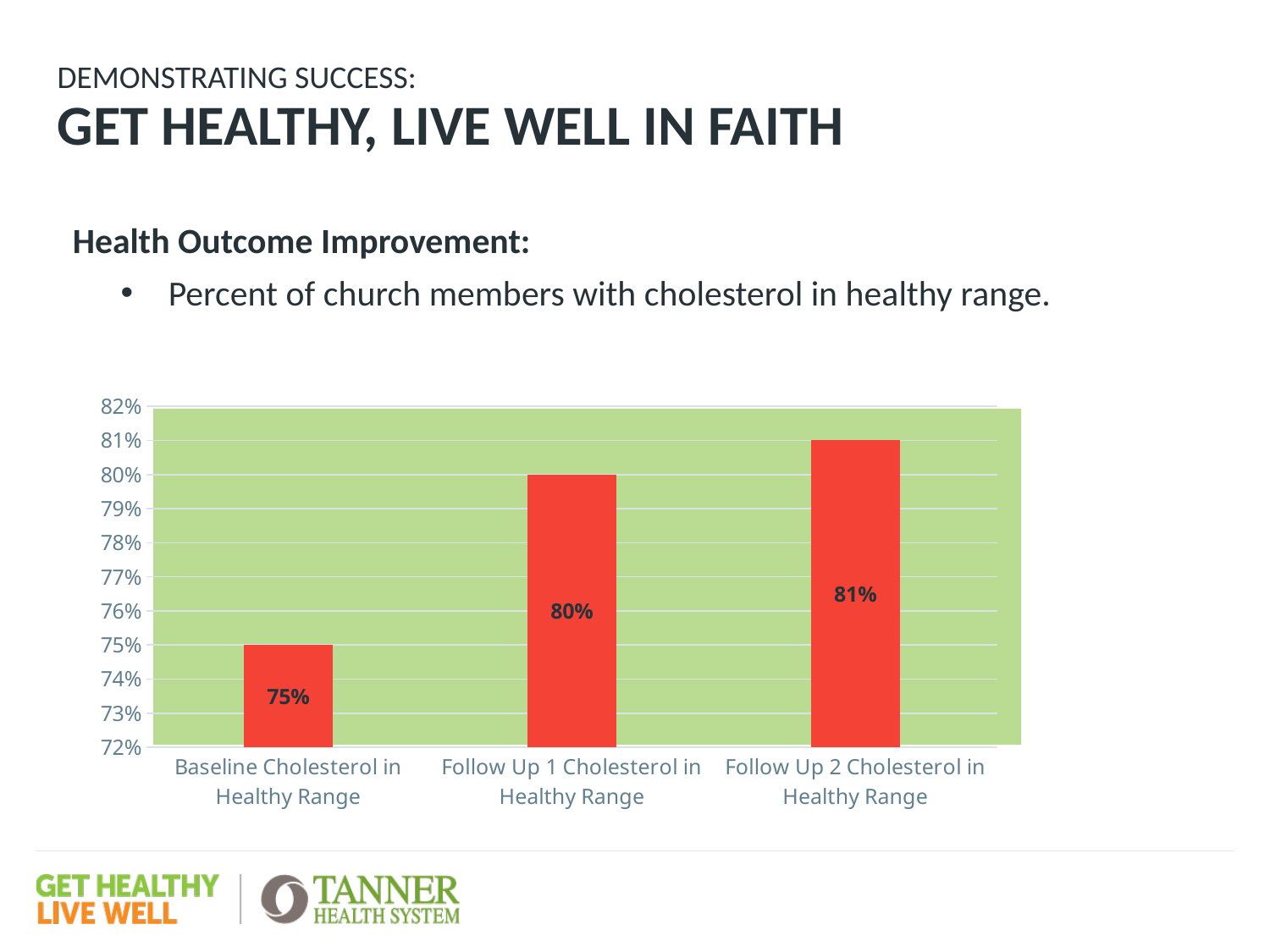
Do the values rise or fall from Baseline to Follow Up 2? rise How many categories are shown in the chart? 3 Is the value for Baseline Cholesterol in Healthy Range greater or less than 78%? less What is the value for Follow Up 1 Cholesterol in Healthy Range? 80% What kind of chart is shown on the slide? bar chart Which category has the lowest value? Baseline Cholesterol in Healthy Range What is the difference between Follow Up 1 and Baseline Cholesterol in Healthy Range? 5% Which category has the highest value? Follow Up 2 Cholesterol in Healthy Range What is the value for Baseline Cholesterol in Healthy Range? 75% What is the difference between Follow Up 2 and Follow Up 1 Cholesterol in Healthy Range? 1% What is the value for Follow Up 2 Cholesterol in Healthy Range? 81% Which is larger, the value for Baseline Cholesterol in Healthy Range or Follow Up 1 Cholesterol in Healthy Range? Follow Up 1 Cholesterol in Healthy Range